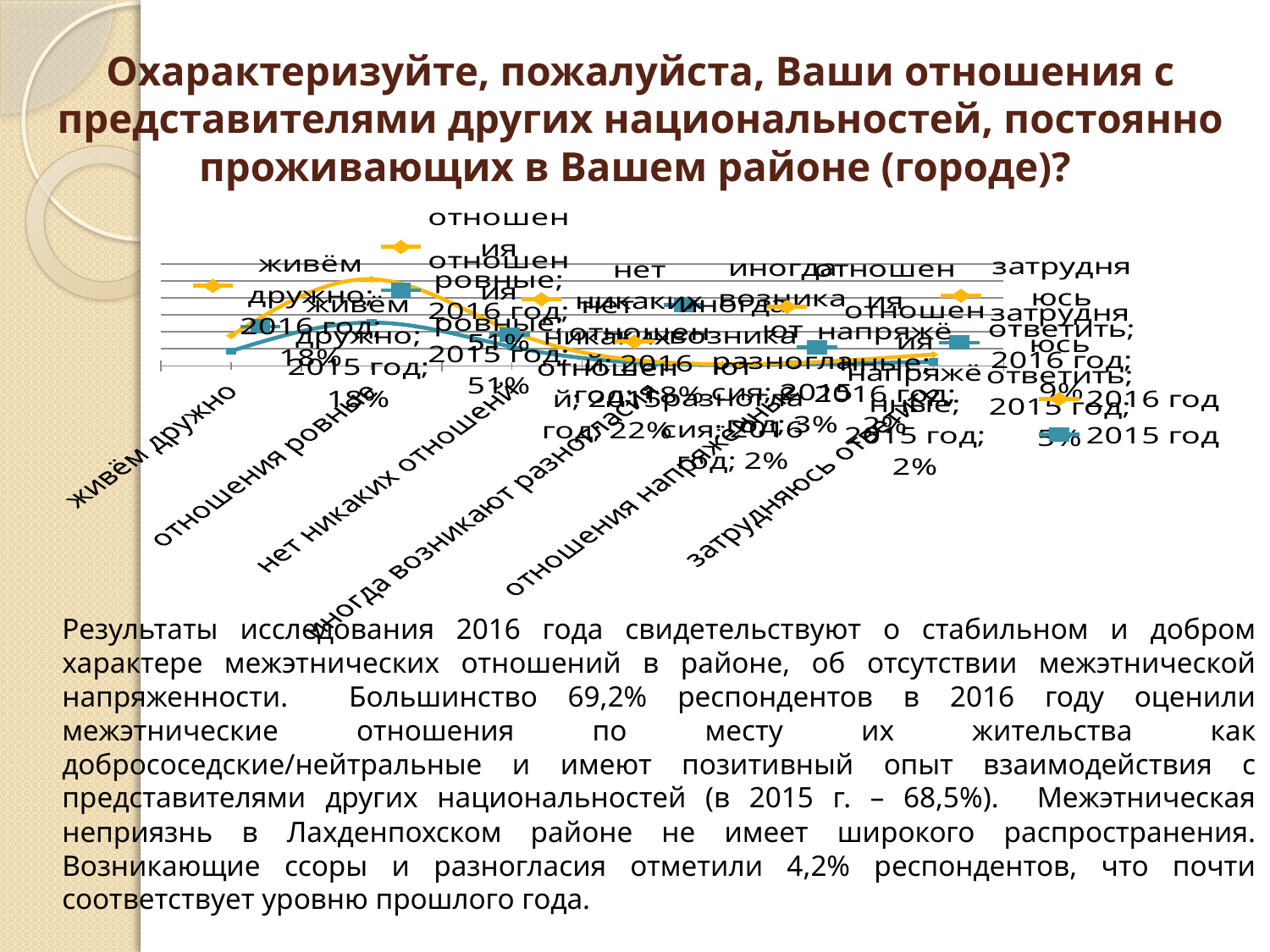
In the 2016 год series, what is the difference between the value for 'отношения ровные' and the value for 'живём дружно'? 33 percentage points What is the value for 'отношения ровные' in the 2016 год series? 51% What is the value for 'живём дружно' in the 2015 год series? 18% In the 2016 год series, which is larger: the value for 'отношения ровные' or for 'живём дружно'? отношения ровные Which category has the highest value for the 2015 год series? отношения ровные What is the value for 'живём дружно' in the 2016 год series? 18% How many categories are plotted along the x axis of the chart? 6 What is the value for 'отношения ровные' in the 2015 год series? 51% Which category has the highest value for the 2016 год series? отношения ровные What kind of chart is shown on the slide? line chart How many series does the chart legend list? 2 Which two series are listed in the chart legend? 2016 год and 2015 год